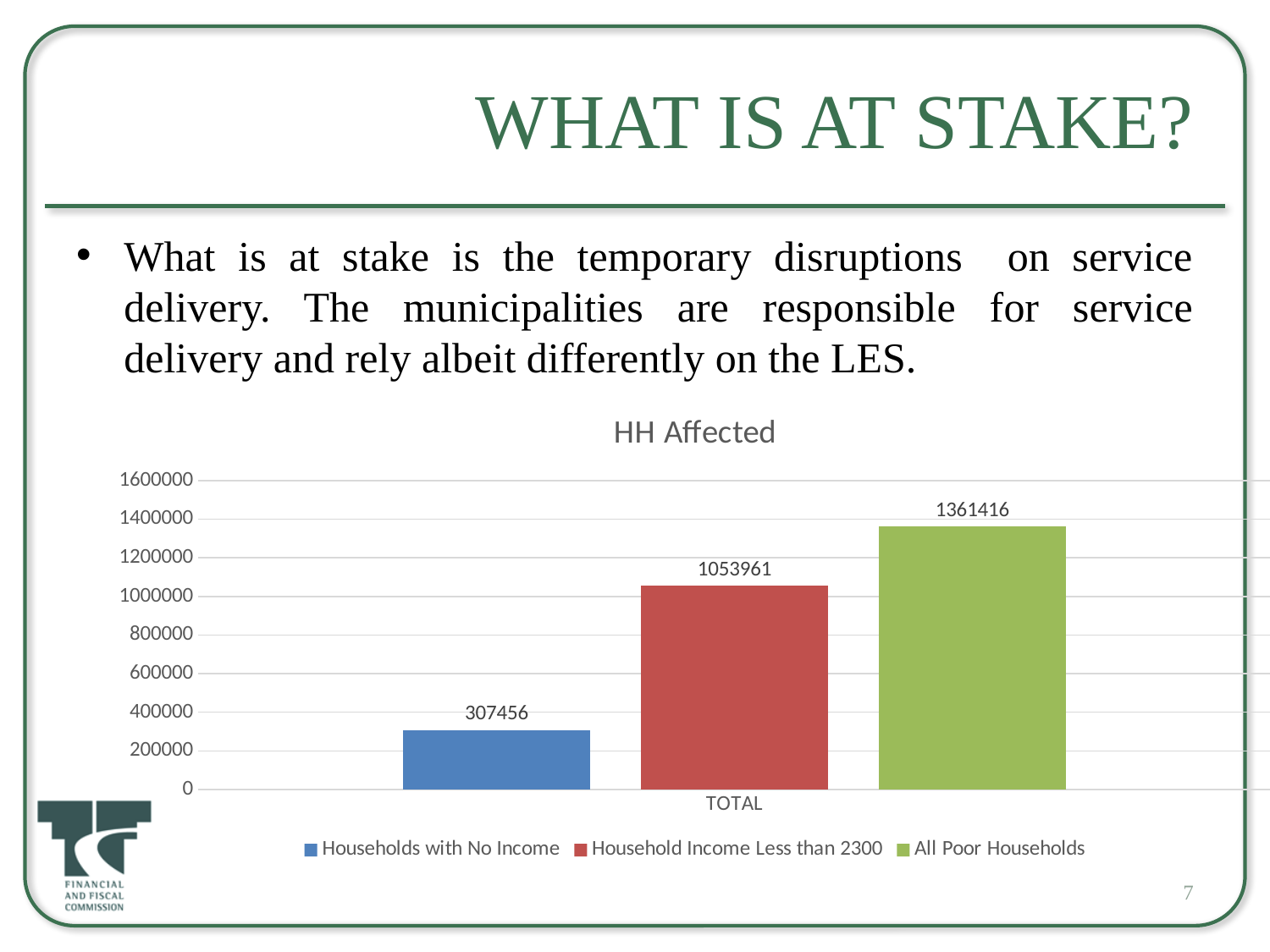
What is the value for Households with No Income? 307456 Which is larger, Household Income Less than 2300 or Households with No Income? Household Income Less than 2300 Which series has the lowest value? Households with No Income What kind of chart is shown? bar chart Which series has the highest value? All Poor Households What is the difference between All Poor Households and Household Income Less than 2300? 307455 What is the difference between All Poor Households and Households with No Income? 1053960 Is the value for Household Income Less than 2300 greater or less than 1000000? greater How many series does the legend list? 3 What is the value for All Poor Households? 1361416 What is the title of the chart? HH Affected What is the value for Household Income Less than 2300? 1053961